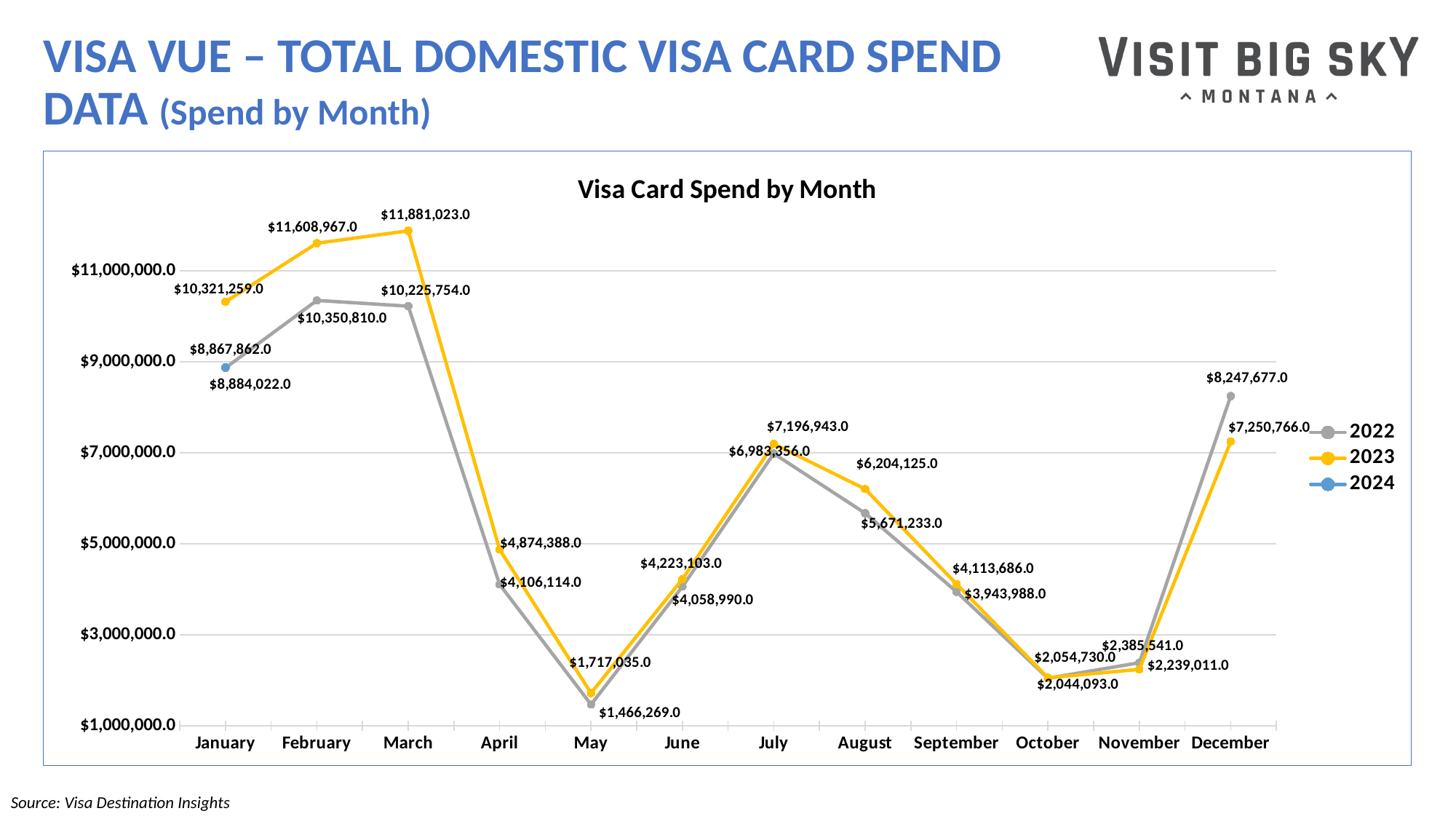
Which years are listed in the legend of the "Visa Card Spend by Month" chart? 2022, 2023, 2024 What kind of chart is "Visa Card Spend by Month"? line chart How many months are shown on the x axis of the "Visa Card Spend by Month" chart? 12 In which month was the 2022 Visa card spend lowest? May How many series does the legend of the "Visa Card Spend by Month" chart list? 3 What was the 2022 Visa card spend in December? $8,247,677.0 What was the 2023 Visa card spend in August? $6,204,125.0 What is the difference between the 2022 and 2023 Visa card spend in December? $996,911.0 What was the 2023 Visa card spend in March? $11,881,023.0 Does the 2023 Visa card spend rise or fall from March to May? fall In which month was the 2023 Visa card spend highest? March Which year had the higher Visa card spend in February, 2022 or 2023? 2023